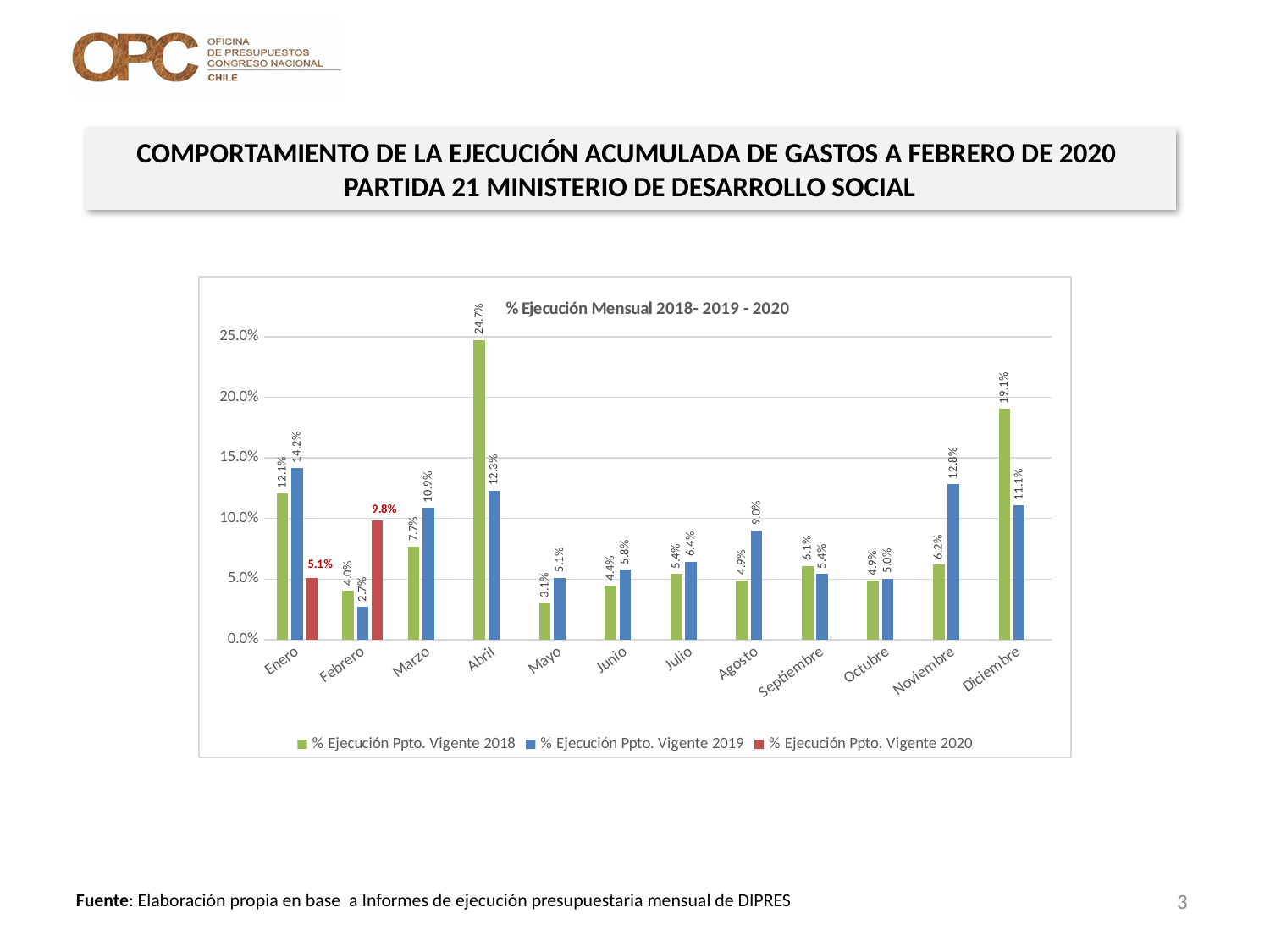
Which is larger for Diciembre: the 2018 value or the 2019 value? 2018 value What is the value of % Ejecución Ppto. Vigente 2018 for Abril? 24.7% What is the value of % Ejecución Ppto. Vigente 2020 for Febrero? 9.8% Which month has the lowest value for % Ejecución Ppto. Vigente 2019? Febrero How many months are shown on the x axis? 12 Is the value of % Ejecución Ppto. Vigente 2019 for Abril greater or less than 10.0%? greater How many series does the legend list? 3 Which month has the highest value for % Ejecución Ppto. Vigente 2018? Abril What is the difference between the 2019 and 2018 values for Enero? 2.1% What is the title of the chart? % Ejecución Mensual 2018- 2019 - 2020 What type of chart is shown on the slide? bar chart What is the value of % Ejecución Ppto. Vigente 2019 for Noviembre? 12.8%